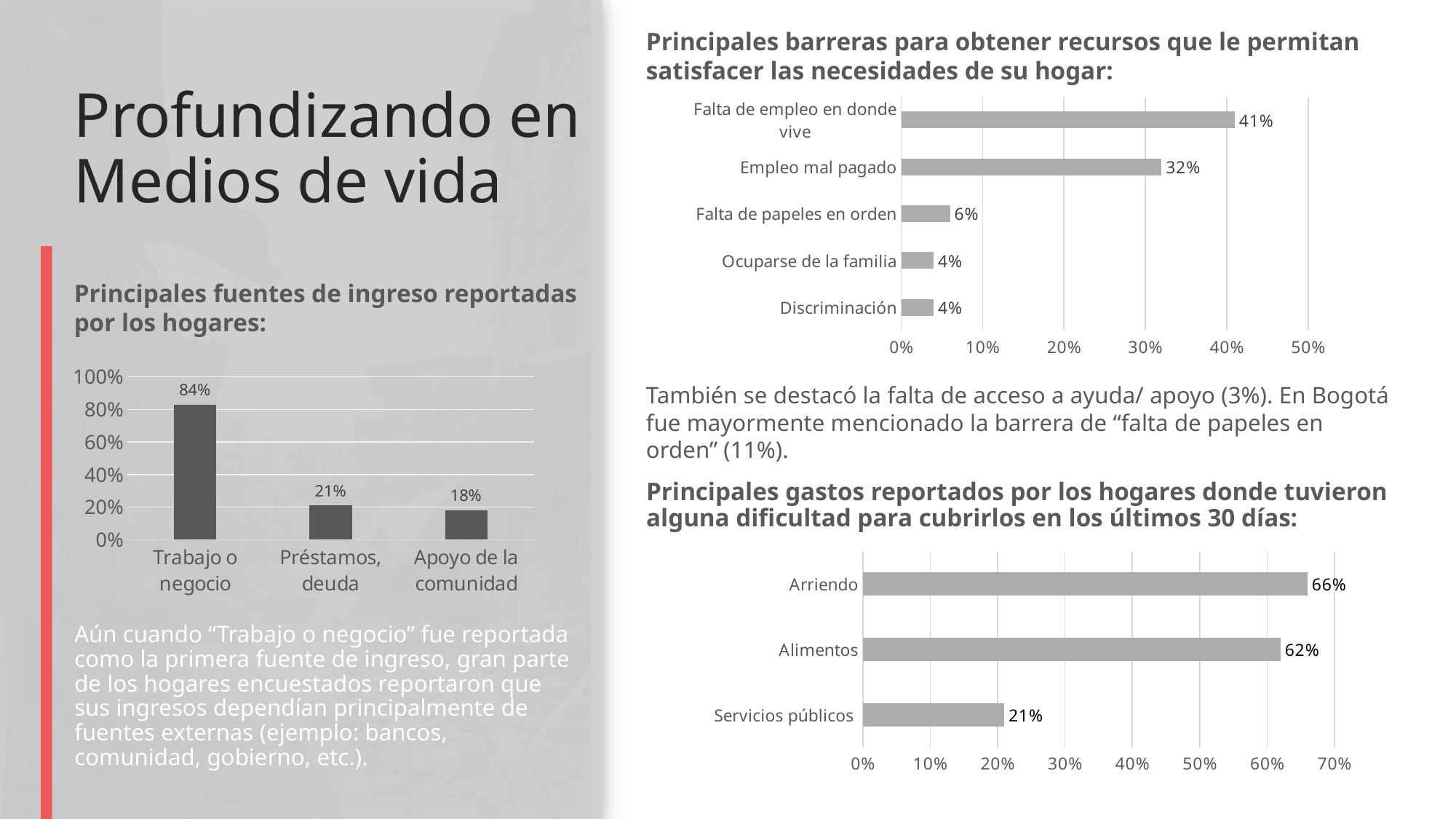
How many categories are shown in the chart 'Principales barreras para obtener recursos'? 5 In the chart 'Principales gastos reportados por los hogares', what is the difference between 'Arriendo' and 'Servicios públicos'? 45% In the chart 'Principales fuentes de ingreso reportadas por los hogares', what is the difference between 'Trabajo o negocio' and 'Préstamos, deuda'? 63% In the chart 'Principales barreras para obtener recursos', which category has the highest value? Falta de empleo en donde vive In the chart 'Principales fuentes de ingreso reportadas por los hogares', which category has the lowest value? Apoyo de la comunidad In the chart 'Principales gastos reportados por los hogares', what is the value for 'Alimentos'? 62% What type of chart is 'Principales gastos reportados por los hogares'? Bar chart In the chart 'Principales gastos reportados por los hogares', which is larger, 'Arriendo' or 'Servicios públicos'? Arriendo In the chart 'Principales barreras para obtener recursos', what is the value for 'Empleo mal pagado'? 32% How many categories are shown in the chart 'Principales fuentes de ingreso reportadas por los hogares'? 3 In the chart 'Principales fuentes de ingreso reportadas por los hogares', what is the value for 'Trabajo o negocio'? 84% In the chart 'Principales barreras para obtener recursos', what is the difference between 'Falta de empleo en donde vive' and 'Empleo mal pagado'? 9%